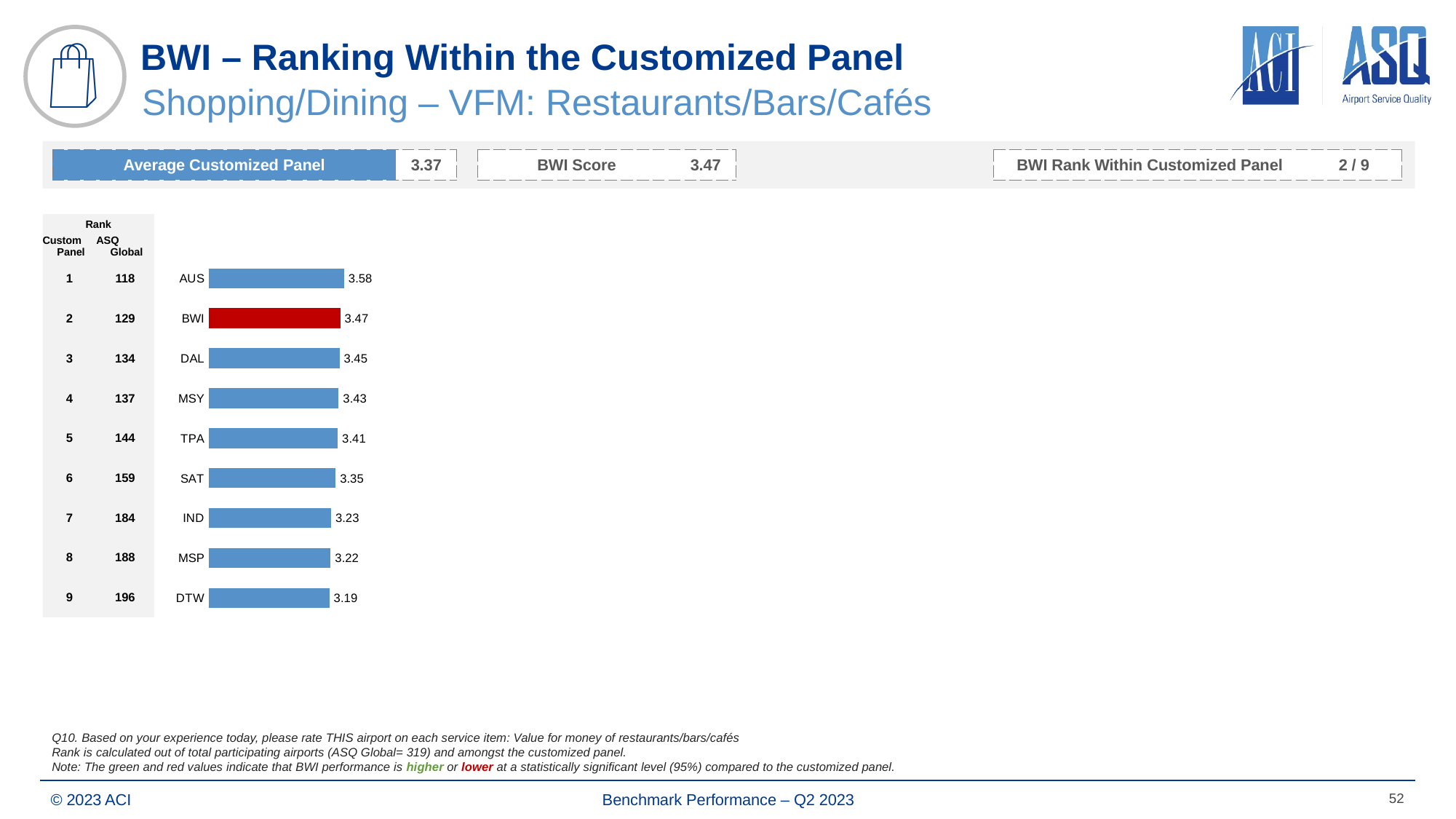
Which airport has the highest value? AUS Which is larger, the value for DAL or the value for MSP? DAL Which airport has the lowest value? DTW What kind of chart is shown? bar chart What is the difference between the values for SAT and IND? 0.12 What is the difference between the values for AUS and BWI? 0.11 Which airport's bar is coloured red? BWI What is the value for TPA? 3.41 Do the values rise or fall from the top bar (AUS) to the bottom bar (DTW)? fall What is the value for DTW? 3.19 What is the value for BWI? 3.47 How many airports are shown in the chart? 9